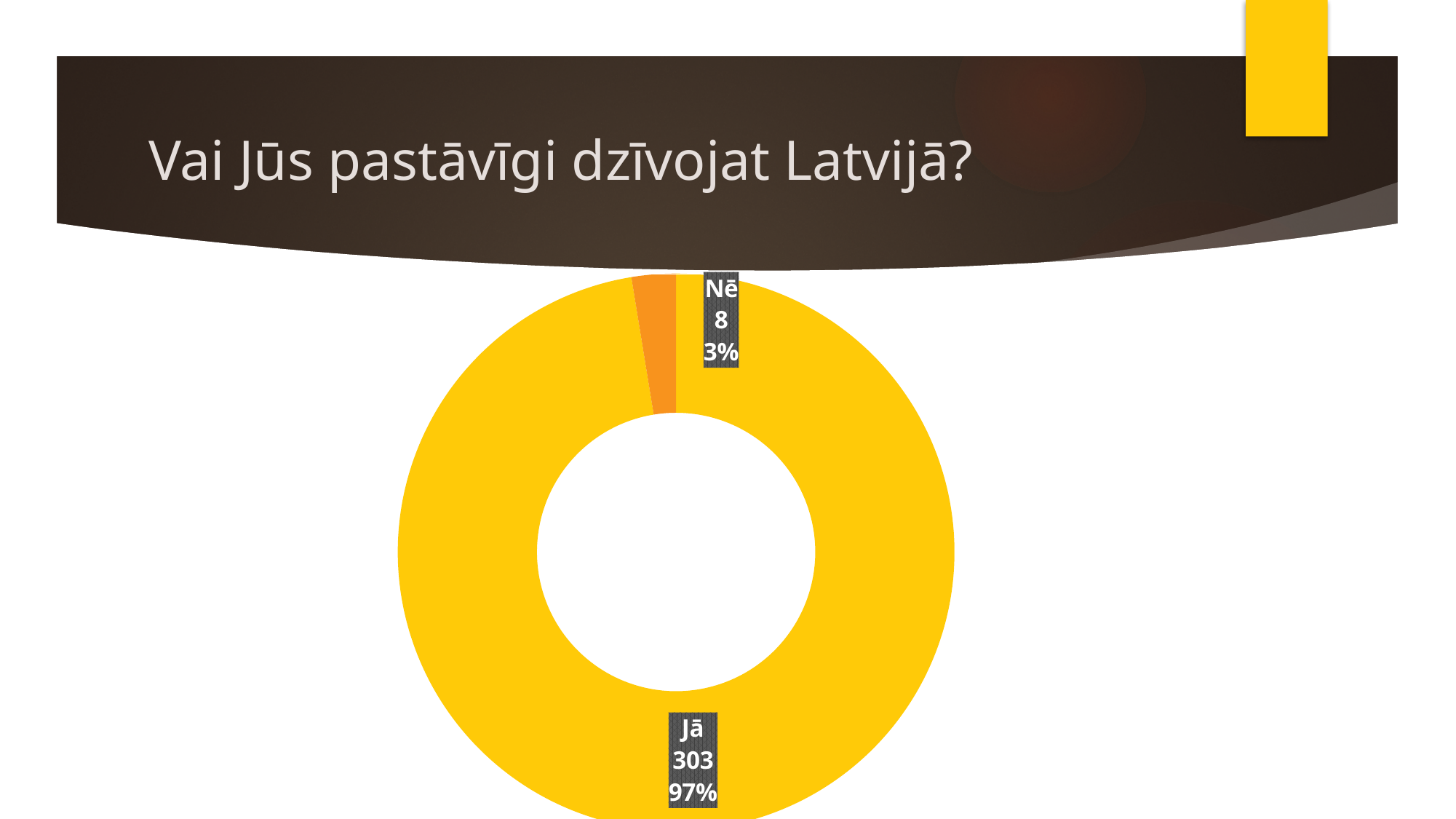
What is the total number of responses shown in the chart? 311 What kind of chart is shown on the slide? Doughnut (pie) chart What percentage of respondents answered "Jā"? 97% Which is larger, the "Jā" slice or the "Nē" slice? Jā Which category has the largest slice? Jā What percentage of respondents answered "Nē"? 3% How many respondents answered "Jā"? 303 Which category has the smallest slice? Nē How many categories does the chart show? 2 What is the title of the slide containing the chart? Vai Jūs pastāvīgi dzīvojat Latvijā? What is the difference between the number of "Jā" and "Nē" responses? 295 How many respondents answered "Nē"? 8